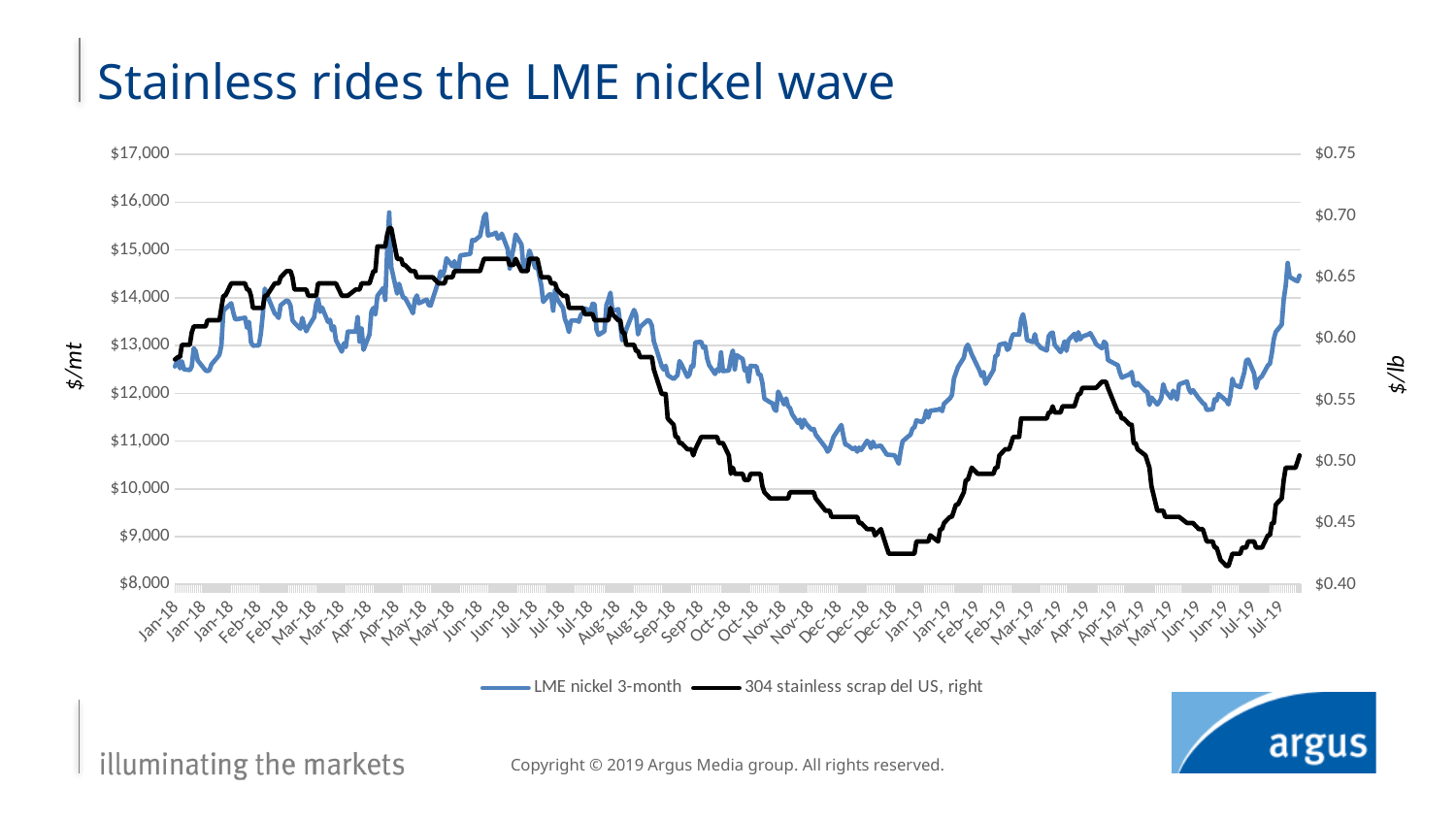
Does the 304 stainless scrap del US series rise or fall between Apr-19 and Jun-19? fall Is the 304 stainless scrap del US value at its peak around Apr-18 greater or less than $0.65? greater Does the 304 stainless scrap del US series rise or fall between Jan-19 and Apr-19? rise Does the LME nickel 3-month series rise or fall between Jun-18 and Dec-18? fall Is the 304 stainless scrap del US value at its lowest point around Jun-19 greater or less than $0.45? less Is the LME nickel 3-month value at its lowest point around Dec-18 greater or less than $11,000? less What is the title of the chart? Stainless rides the LME nickel wave Which series is plotted against the right-hand axis? 304 stainless scrap del US What kind of chart is shown on the slide? line chart How many series does the legend list? 2